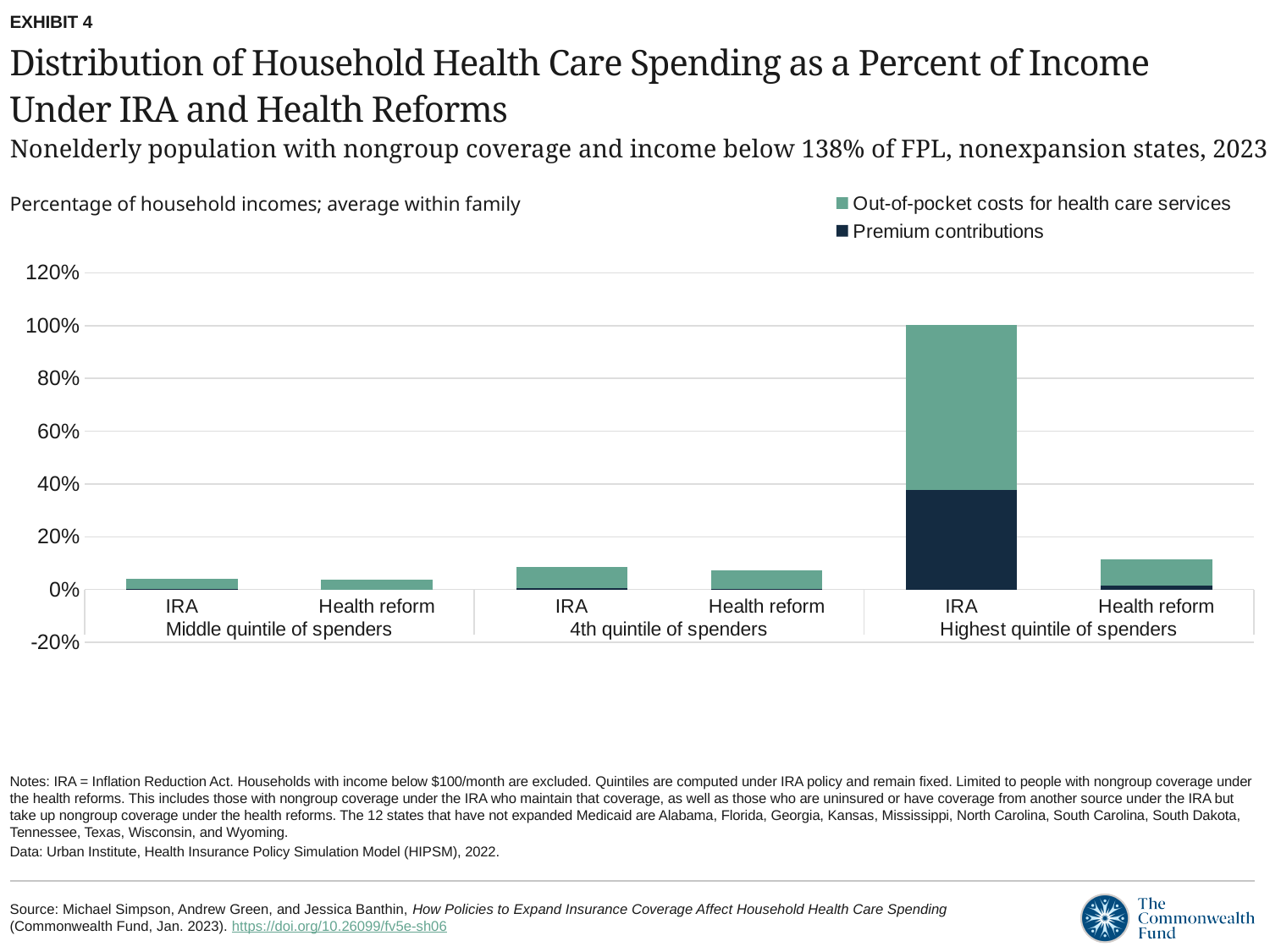
Which bar is the tallest in the chart? IRA, Highest quintile of spenders Is the total value for IRA in the highest quintile of spenders greater or less than 80%? greater In the highest quintile of spenders, which is larger: the IRA bar or the Health reform bar? IRA How many series does the legend list? 2 Which is larger: the IRA bar for the 4th quintile of spenders or the IRA bar for the middle quintile of spenders? 4th quintile of spenders Is the premium contributions portion for IRA in the highest quintile of spenders greater or less than 20%? greater How many bars are plotted in the chart? 6 What kind of chart is shown on the slide? Bar chart Which series is shown in dark navy in the legend? Premium contributions Is the total value for Health reform in the highest quintile of spenders greater or less than 20%? less How many quintile groups of spenders are shown along the x axis? 3